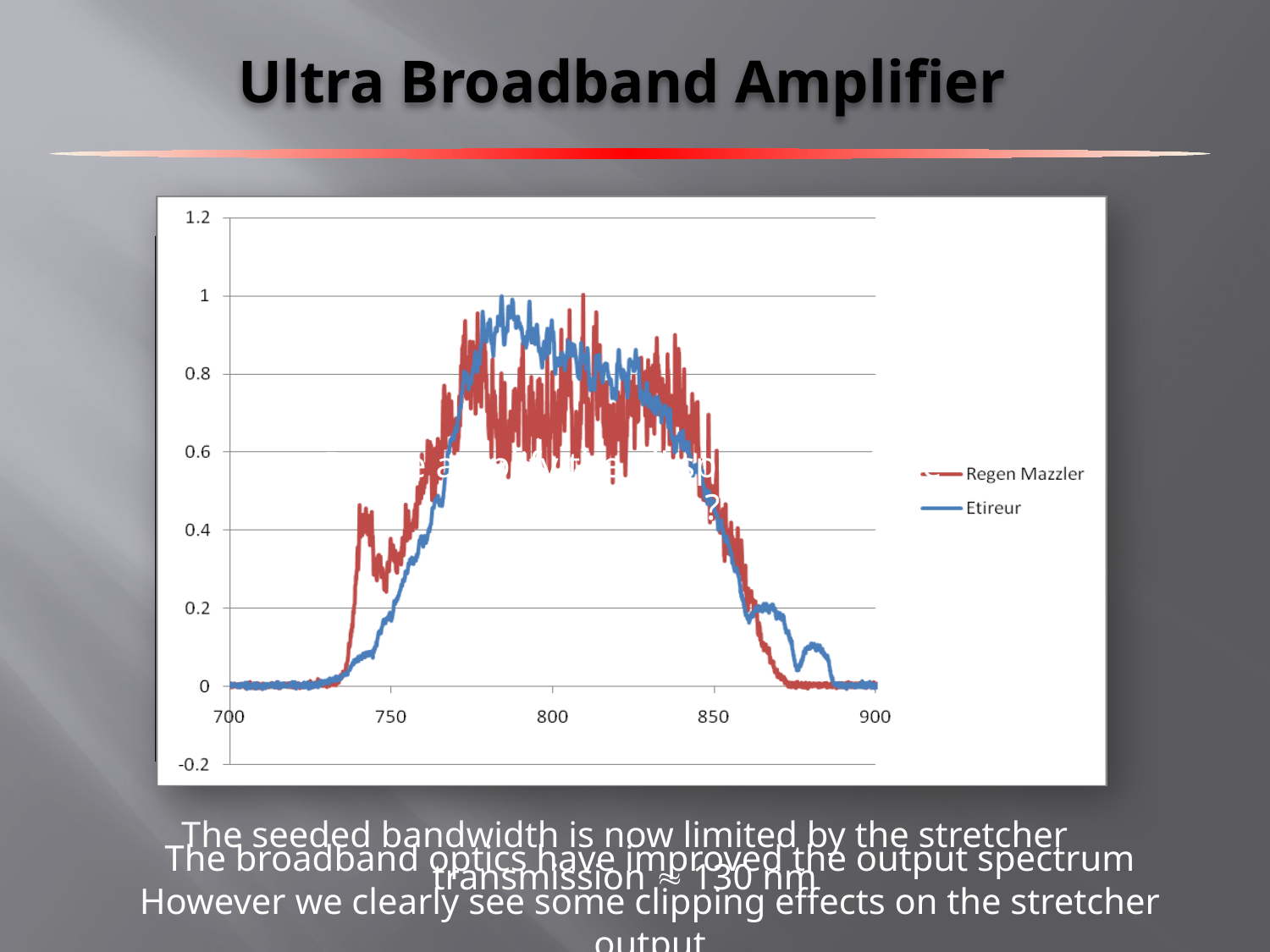
Is the value for Etireur at 750 greater or less than 0.4? less How many series does the legend list? 2 What kind of chart is shown on the slide? line chart Does the Regen Mazzler line rise or fall between 850 and 900 on the x axis? fall Is the value for Etireur at 875 greater or less than 0.4? less Is the value for Etireur at 800 greater or less than 0.6? greater What colour is the Etireur line? blue What are the two series named in the legend? Regen Mazzler and Etireur Does the Etireur line rise or fall between 700 and 780 on the x axis? rise